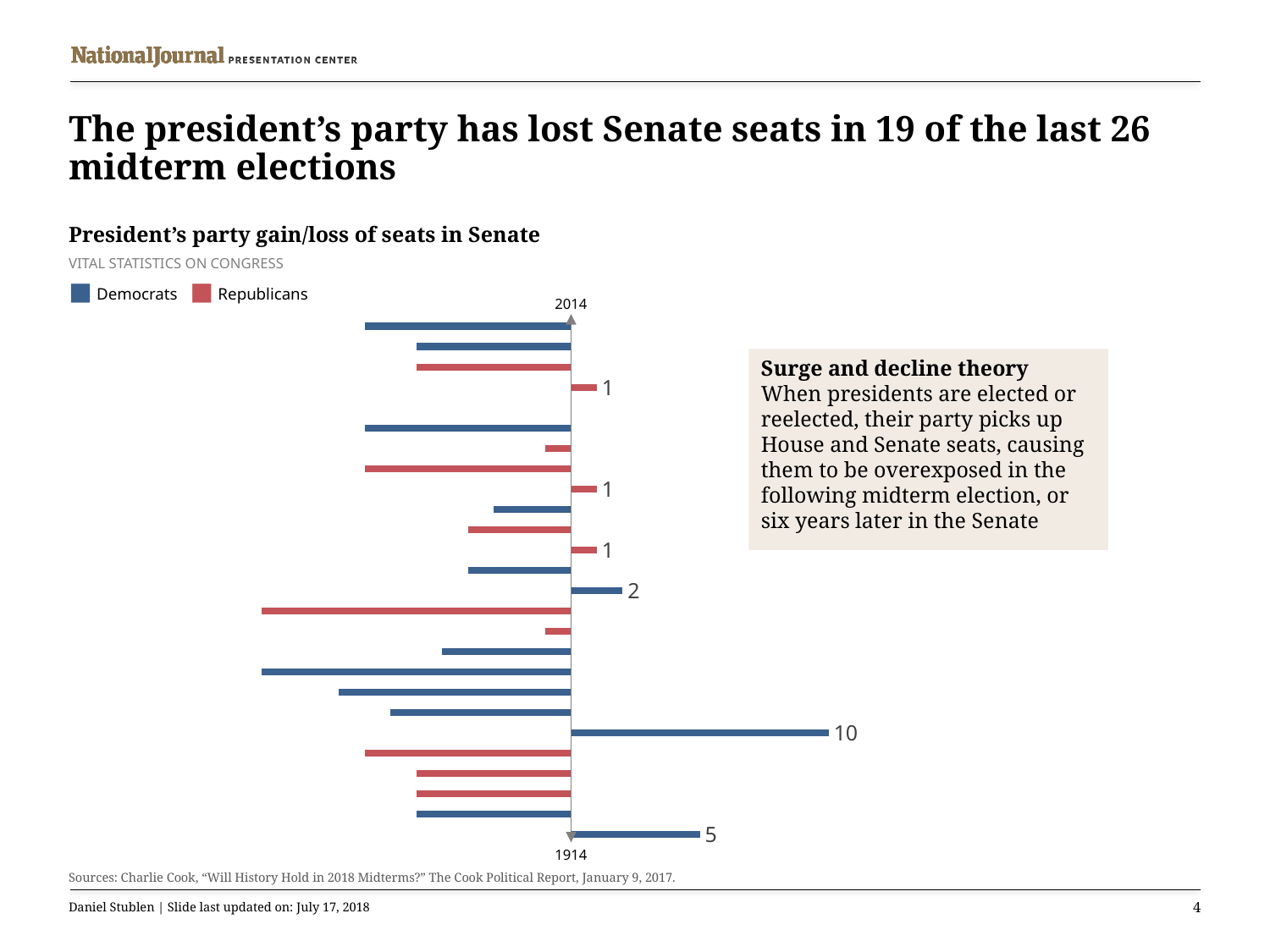
What is the largest labeled seat gain shown on the chart? 10 What is the title of the chart? President's party gain/loss of seats in Senate Which party do the three bars labeled 1 belong to? Republicans How many series does the legend list? 2 Which party does the 1914 bar (gain of 5) belong to? Democrats What is the difference between the largest labeled gain (10) and the 1914 gain (5)? 5 Which is larger: the gain labeled 10 or the gain labeled 5 for 1914? The gain labeled 10 What is the labeled value of the bottom bar, for 1914? 5 Which party does the bar with the largest gain (10 seats) belong to? Democrats What kind of chart is shown on the slide? Bar chart How many bars on the chart show a seat gain (extend to the right of the axis)? 6 Which two series are listed in the chart legend? Democrats and Republicans